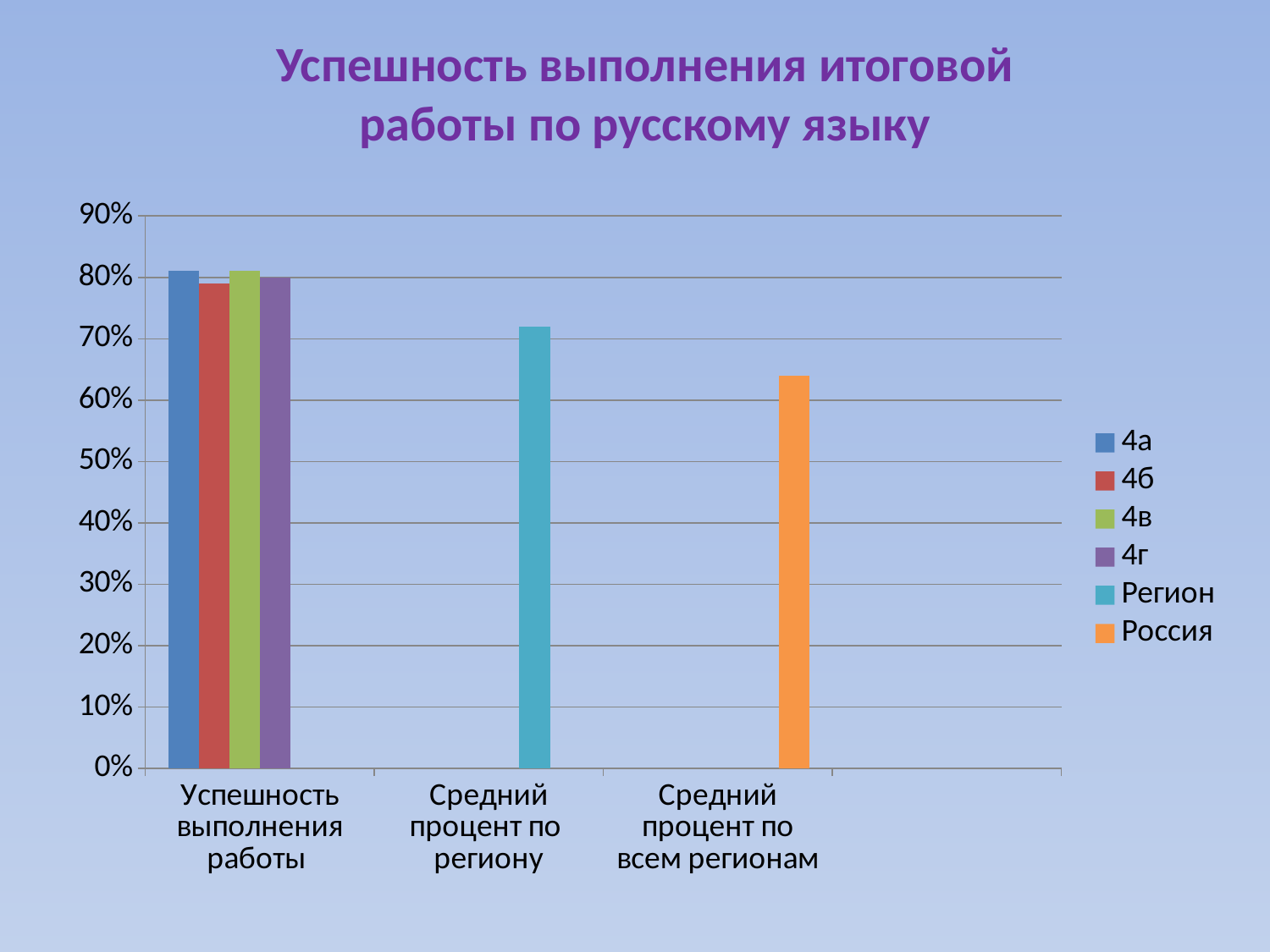
Is the value for Регион greater or less than 80%? less Is the value for 4б greater or less than 70%? greater Which series has the lowest bar on the chart? Россия Is the value for 4г greater or less than 90%? less What is the title of the chart? Успешность выполнения итоговой работы по русскому языку How many categories are shown on the x axis? 3 Which is larger, the bar for 4б or the bar for Россия? 4б What kind of chart is shown on the slide? bar chart How many series does the legend list? 6 Which is larger, the bar for 4а or the bar for Регион? 4а Which is larger, the bar for Регион or the bar for Россия? Регион